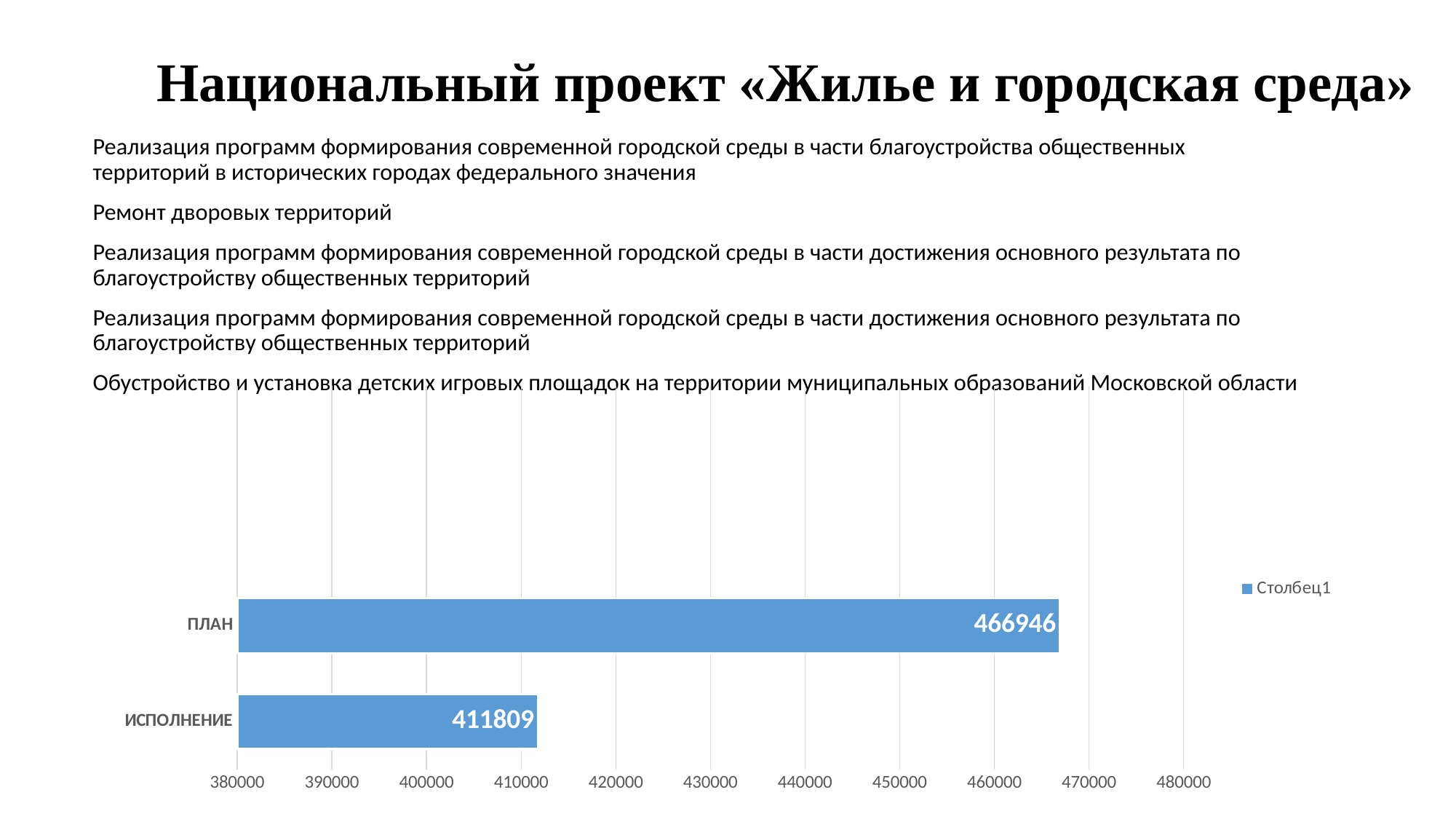
Which is larger, the value for ПЛАН or the value for ИСПОЛНЕНИЕ? ПЛАН What is the name of the series shown in the legend? Столбец1 Is the value for ПЛАН greater or less than 460000? greater Is the value for ИСПОЛНЕНИЕ greater or less than 420000? less What is the value for ИСПОЛНЕНИЕ? 411809 Which category has the lowest value? ИСПОЛНЕНИЕ Which category has the highest value? ПЛАН How many series does the legend list? 1 How many categories are shown in the chart? 2 What is the difference between the values for ПЛАН and ИСПОЛНЕНИЕ? 55137 What kind of chart is shown on the slide? bar chart What is the value for ПЛАН? 466946